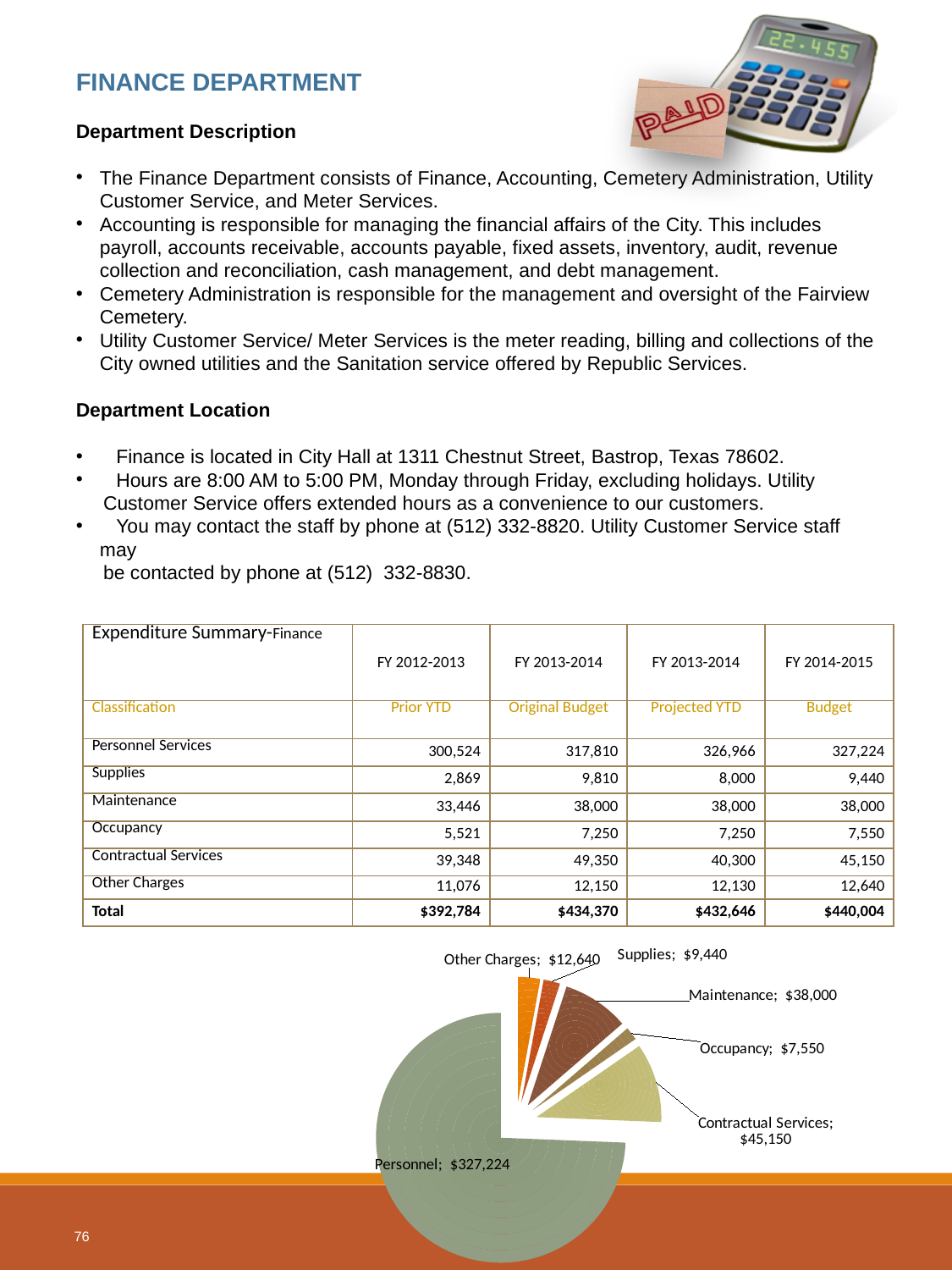
How many slices does the pie chart have? 6 What is the value shown for Personnel in the pie chart? $327,224 In the pie chart, what is the difference between Other Charges and Occupancy? $5,090 What is the value shown for Contractual Services in the pie chart? $45,150 Which category has the smallest slice in the pie chart? Occupancy What is the value shown for Maintenance in the pie chart? $38,000 In the pie chart, what is the difference between Maintenance and Supplies? $28,560 Which category has the largest slice in the pie chart? Personnel In the pie chart, what is the difference between Contractual Services and Maintenance? $7,150 What type of chart is shown at the bottom of the slide? pie chart In the pie chart, which is larger: Other Charges or Supplies? Other Charges What is the value shown for Occupancy in the pie chart? $7,550